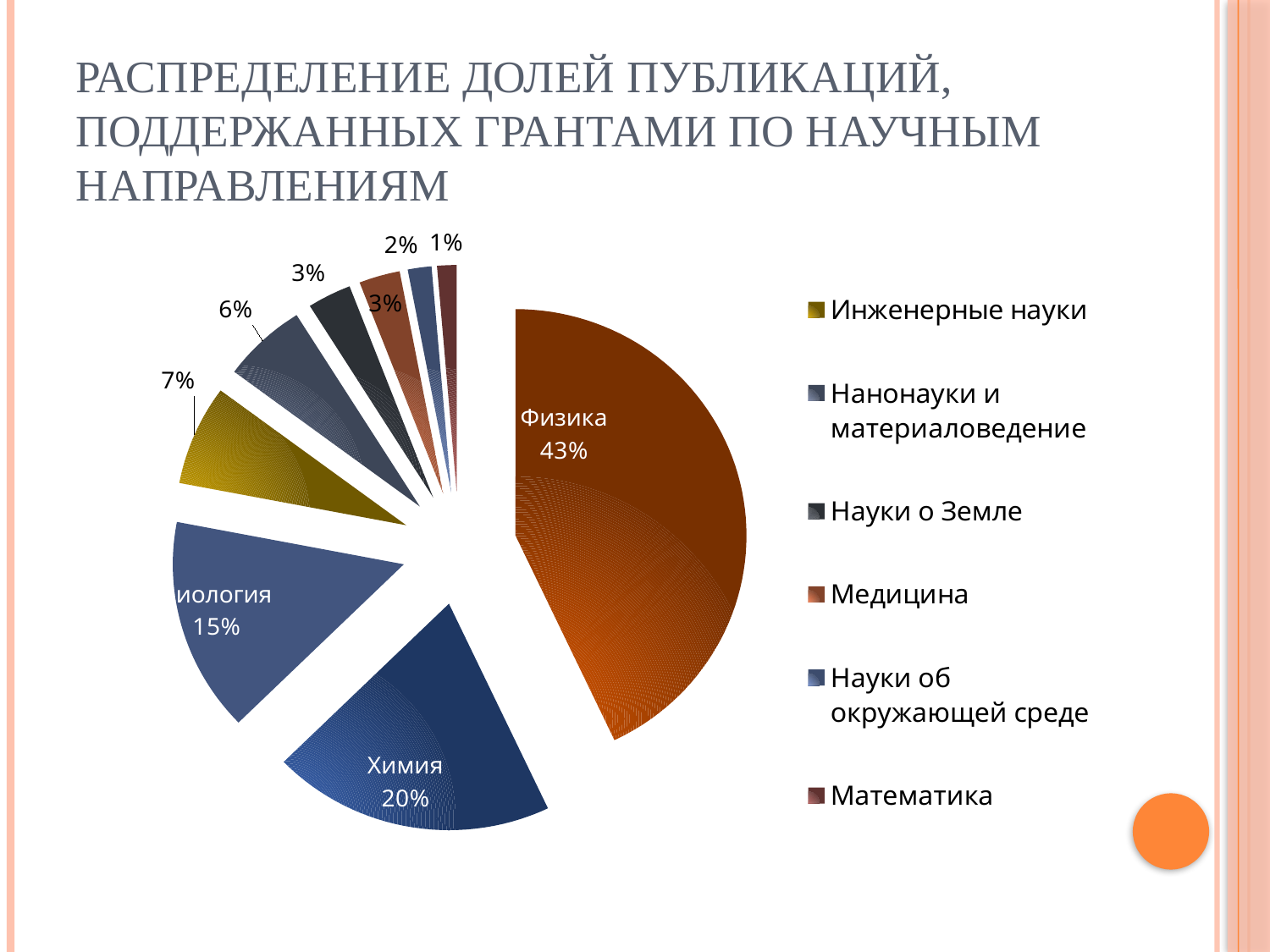
Which is larger, the share for Химия or the share for Биология? Химия How many percentage points larger is the Физика share than the Химия share? 23 What percentage does Математика have? 1% What is the share of Нанонауки и материаловедение? 6% Which scientific field has the largest share of the pie? Физика What type of chart is shown on the slide? Pie chart Which field has the smallest share of the pie? Математика How many entries are listed in the legend? 6 What share is shown for the yellow slice, Инженерные науки? 7% What share of publications does Физика account for? 43% How many slices does the pie chart have? 9 What percentage is shown for Химия? 20%